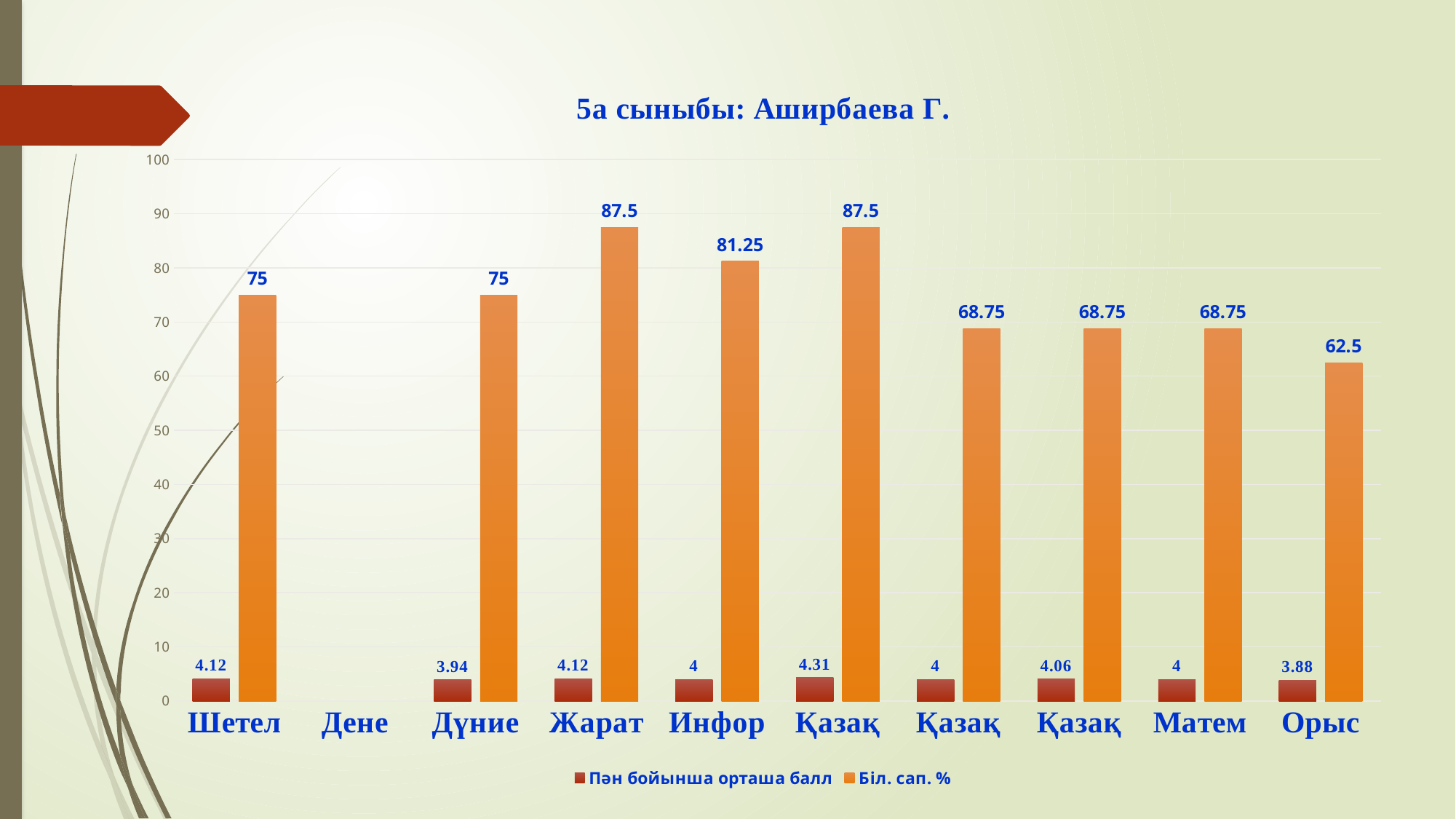
What is the value of Біл. сап. % for Инфор? 81.25 Is the Біл. сап. % value for Матем greater or less than 60? greater How many series does the legend list? 2 Which category has the lowest value of Пән бойынша орташа балл? Орыс Which has a higher Біл. сап. % value, Инфор or Дүние? Инфор Which category has the lowest value of Біл. сап. %? Орыс What is the difference between the Біл. сап. % values for Жарат and Орыс? 25 How many categories are shown on the x axis? 10 What is the value of Пән бойынша орташа балл for Дүние? 3.94 What is the value of Пән бойынша орташа балл for Орыс? 3.88 What is the value of Біл. сап. % for Жарат? 87.5 What type of chart is shown on the slide? Bar chart